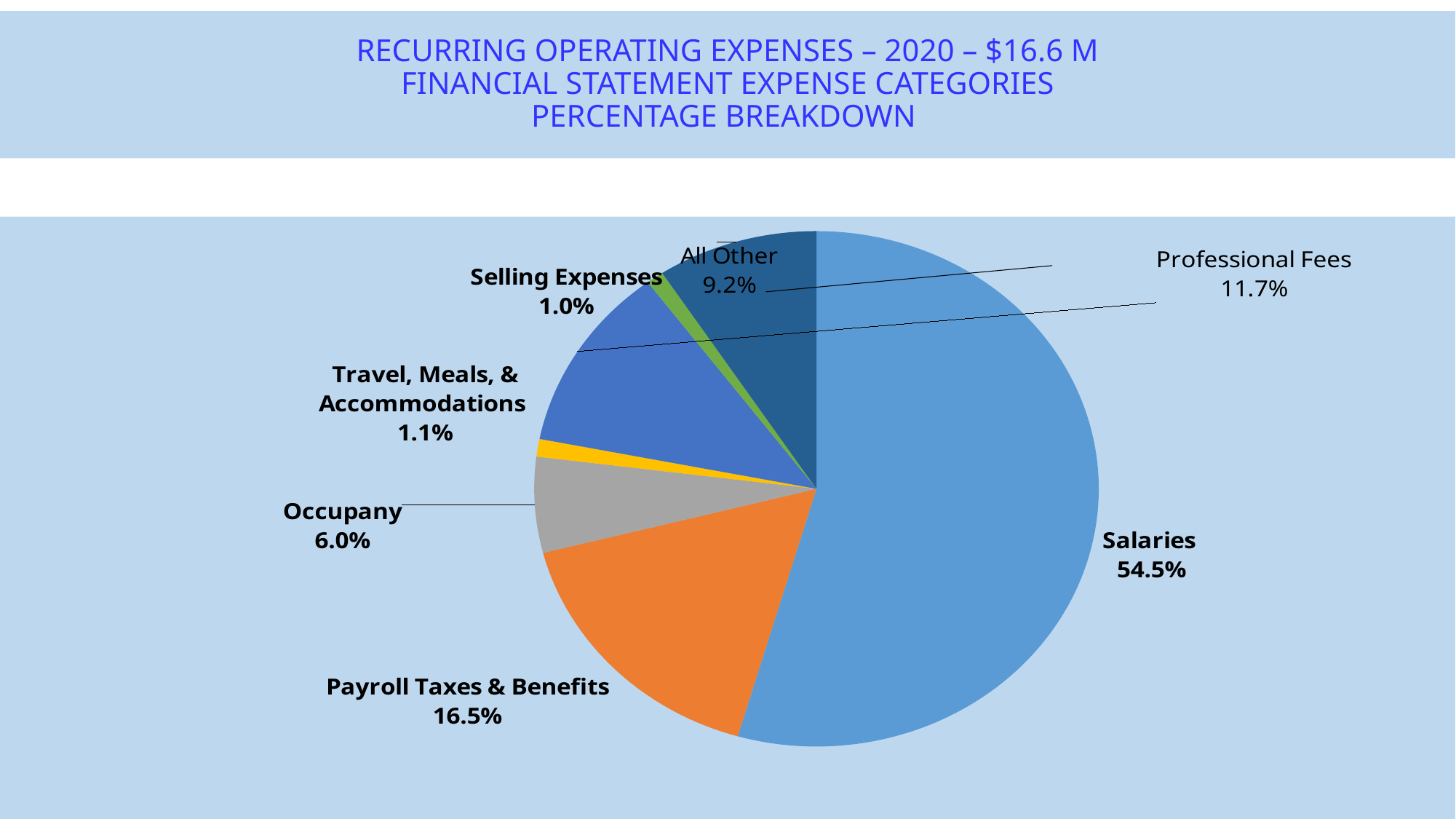
How many expense categories are shown in the pie chart? 7 What total dollar amount of recurring operating expenses does the chart title state for 2020? $16.6 M Which expense category has the largest share of the pie? Salaries What kind of chart is shown on the slide? Pie chart Which is larger, Professional Fees or All Other? Professional Fees What percentage of recurring operating expenses is Salaries? 54.5% Which expense category has the smallest share of the pie? Selling Expenses What is the value for All Other? 9.2% What is the difference in percentage points between Salaries and Payroll Taxes & Benefits? 38.0 What share of the pie is Payroll Taxes & Benefits? 16.5% What percentage is shown for Occupany? 6.0% What is the value shown for Professional Fees? 11.7%